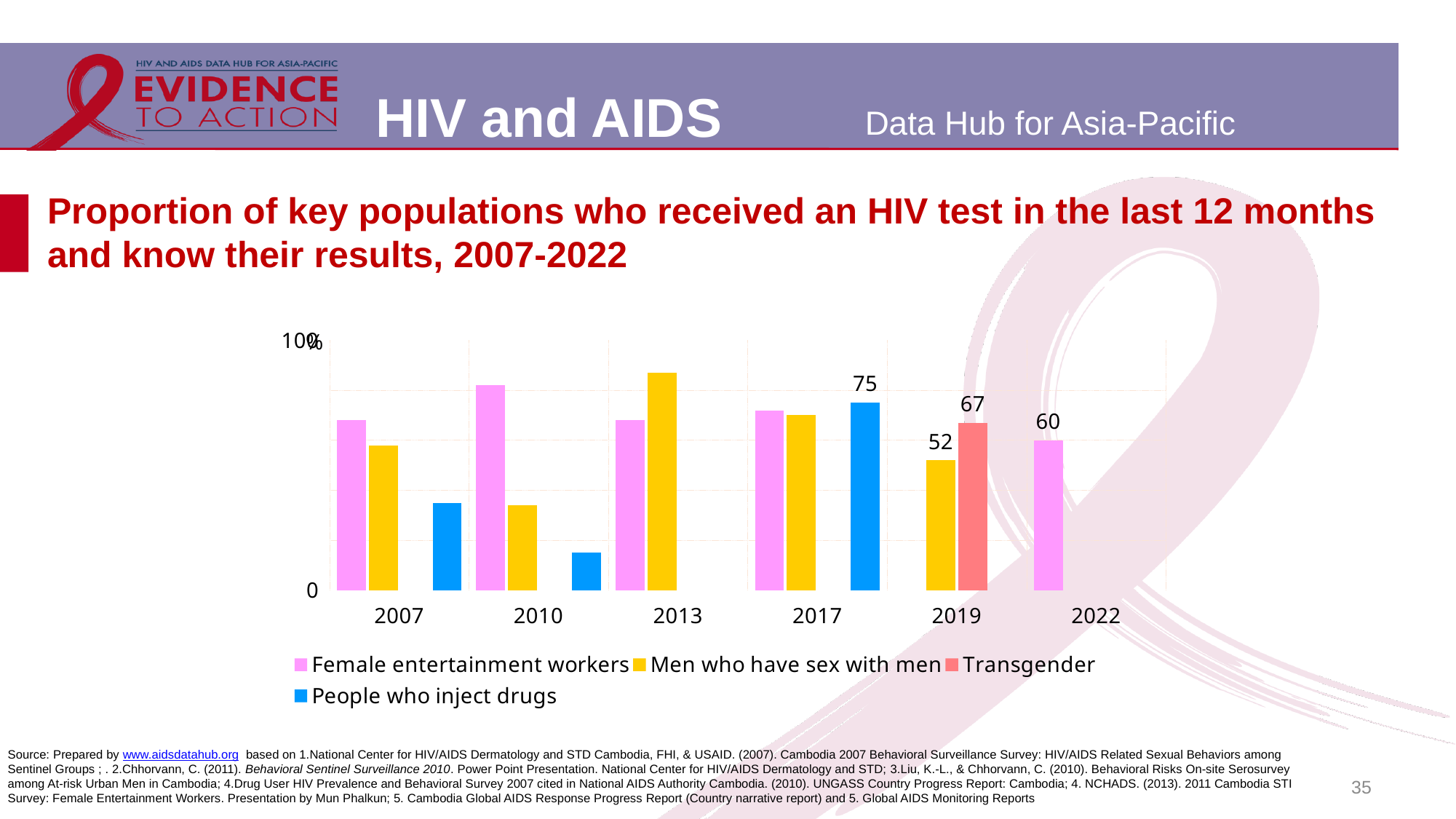
In 2010, which key population has the lowest value? People who inject drugs Which series is shown in blue in the legend? People who inject drugs What is the value for Female entertainment workers in 2022? 60 What is the value for Men who have sex with men in 2019? 52 What kind of chart is shown on the slide? Bar chart In 2010, which key population has the highest value? Female entertainment workers How many years are shown on the x axis? 6 In 2019, which is larger: the value for Transgender or for Men who have sex with men? Transgender In 2019, what is the difference between the Transgender value and the Men who have sex with men value? 15 How many series does the legend list? 4 What is the value for People who inject drugs in 2017? 75 What is the value for Transgender in 2019? 67